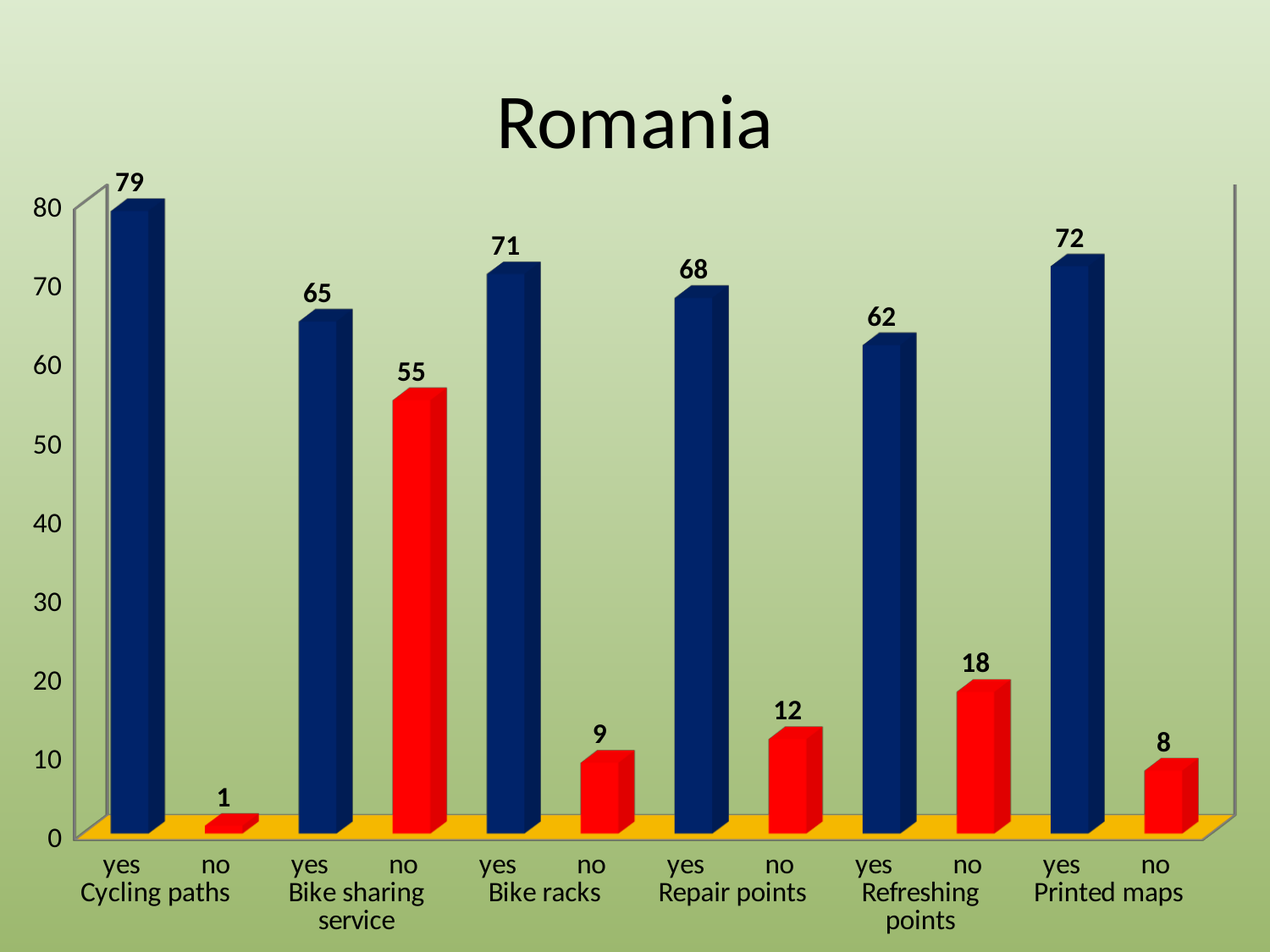
Which bar has the lowest value on the chart? no, Cycling paths What is the value for 'yes' under Cycling paths? 79 Which is larger: the 'yes' value for Repair points or the 'yes' value for Printed maps? Printed maps What is the value for 'yes' under Refreshing points? 62 Which bar has the highest value on the chart? yes, Cycling paths What kind of chart is shown on the slide? bar chart What is the value for 'no' under Printed maps? 8 What is the value for 'no' under Bike sharing service? 55 What is the title of the chart? Romania What is the difference between the 'yes' and 'no' values for Bike racks? 62 How many bars are plotted on the chart? 12 Is the 'no' value for Refreshing points greater or less than 20? less